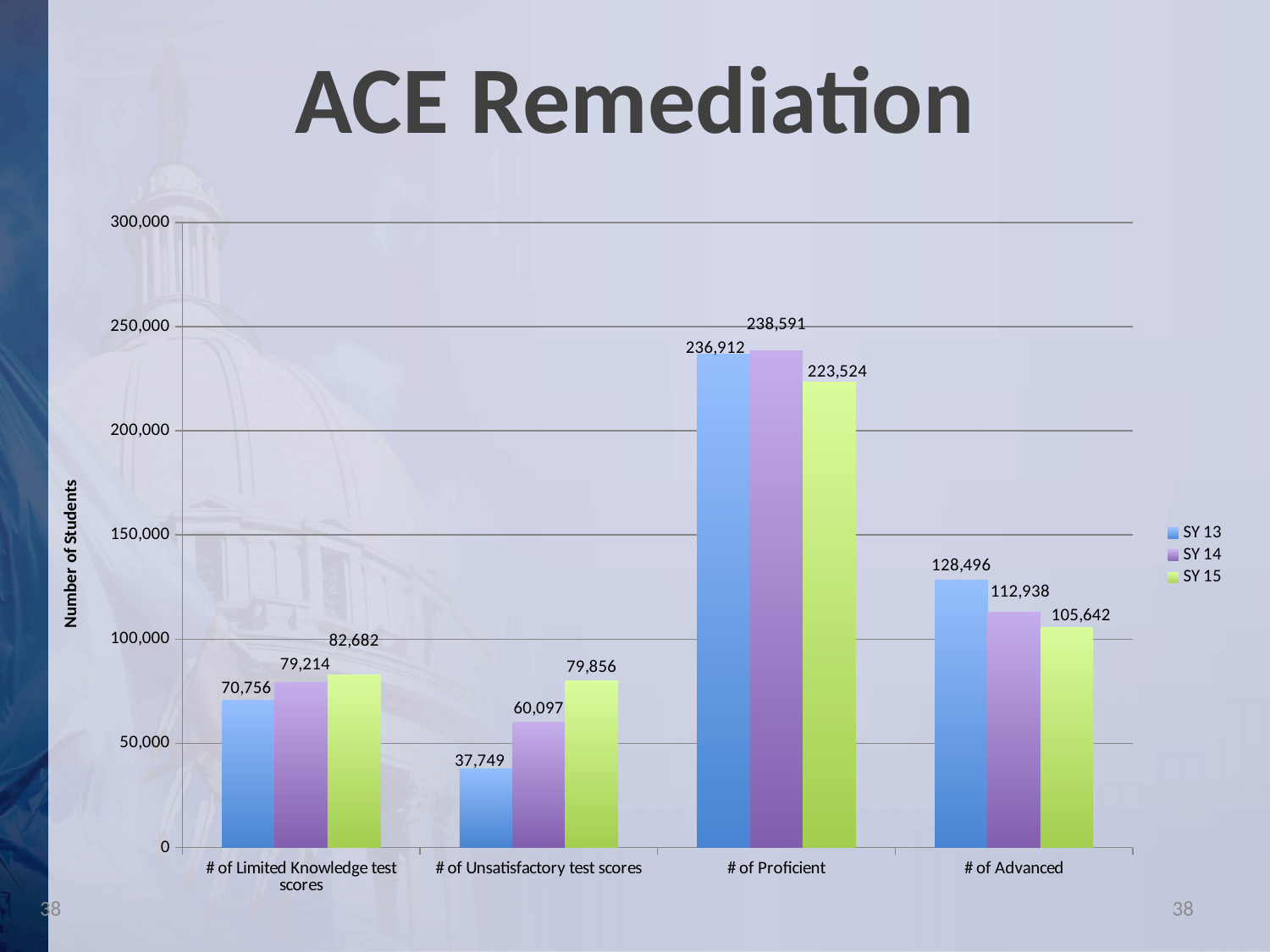
Is the SY 14 value for # of Advanced greater or less than 100,000? greater What is the value for SY 14 in the # of Advanced category? 112,938 What kind of chart is shown on the slide? bar chart What is the difference between the SY 13 and SY 15 values in the # of Advanced category? 22,854 What is the value for SY 15 in the # of Proficient category? 223,524 What is the value for SY 13 in the # of Unsatisfactory test scores category? 37,749 How many categories are shown on the x axis? 4 Which category has the highest value for SY 13? # of Proficient Which is larger in the # of Limited Knowledge test scores category, SY 13 or SY 15? SY 15 How many series does the legend list? 3 Which category has the lowest value for SY 15? # of Unsatisfactory test scores What is the difference between the SY 15 and SY 13 values in the # of Unsatisfactory test scores category? 42,107